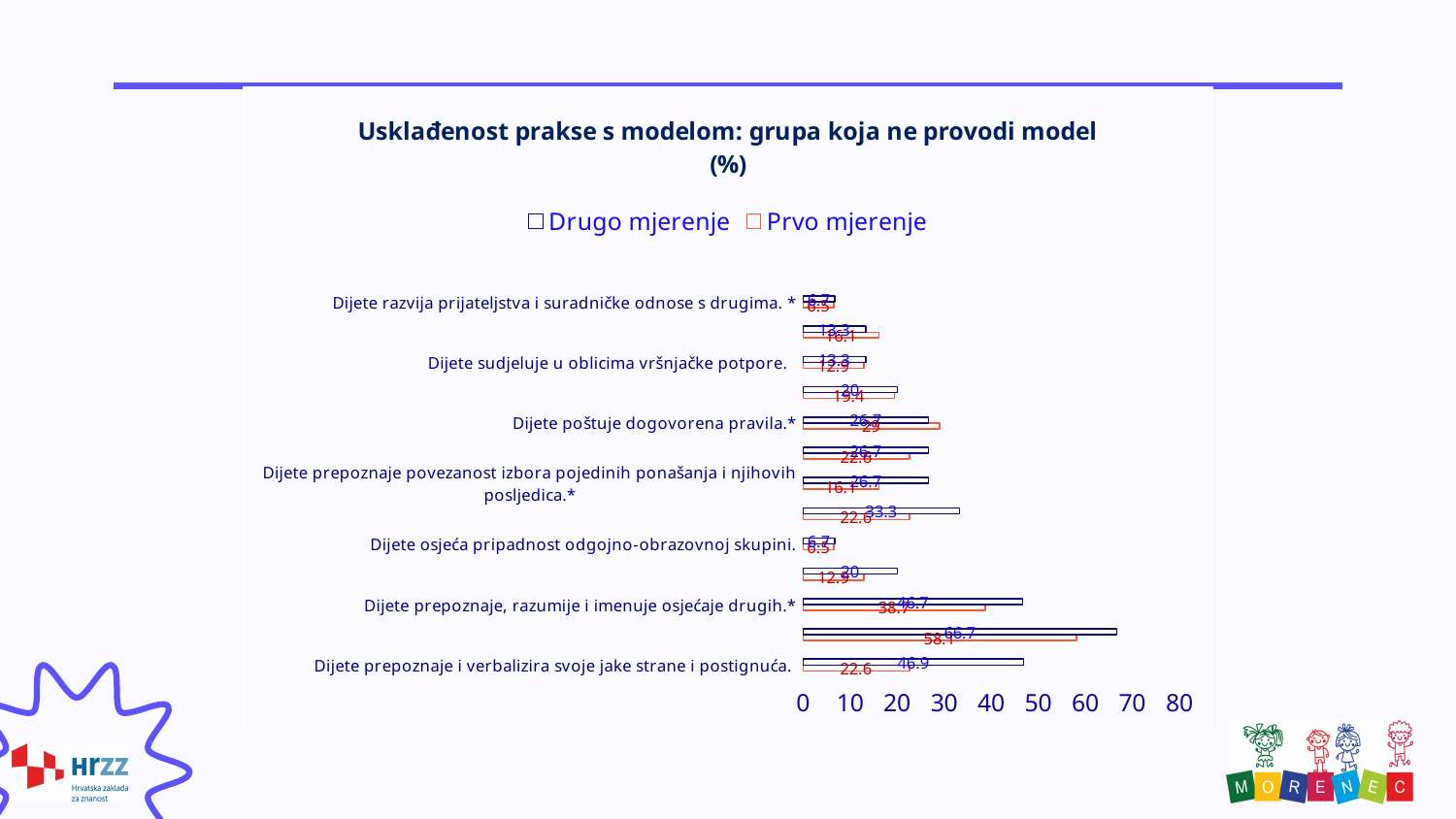
For 'Dijete prepoznaje i verbalizira svoje jake strane i postignuća.', which series has the larger value, Drugo mjerenje or Prvo mjerenje? Drugo mjerenje Is the Drugo mjerenje value for 'Dijete razvija prijateljstva i suradničke odnose s drugima. *' greater or less than 10? less What are the two series named in the legend? Drugo mjerenje and Prvo mjerenje What kind of chart is shown on the slide? bar chart What is the Prvo mjerenje value for 'Dijete prepoznaje, razumije i imenuje osjećaje drugih.*'? 38.7 What is the difference between the Drugo mjerenje and Prvo mjerenje values for 'Dijete prepoznaje, razumije i imenuje osjećaje drugih.*'? 8 Is the Prvo mjerenje value for 'Dijete prepoznaje i verbalizira svoje jake strane i postignuća.' greater or less than 30? less How many series does the legend list? 2 What is the title of the chart? Usklađenost prakse s modelom: grupa koja ne provodi model (%) For 'Dijete prepoznaje, razumije i imenuje osjećaje drugih.*', which series has the larger value, Drugo mjerenje or Prvo mjerenje? Drugo mjerenje Is the Drugo mjerenje value for 'Dijete prepoznaje, razumije i imenuje osjećaje drugih.*' greater or less than 40? greater What is the Drugo mjerenje value for 'Dijete prepoznaje, razumije i imenuje osjećaje drugih.*'? 46.7